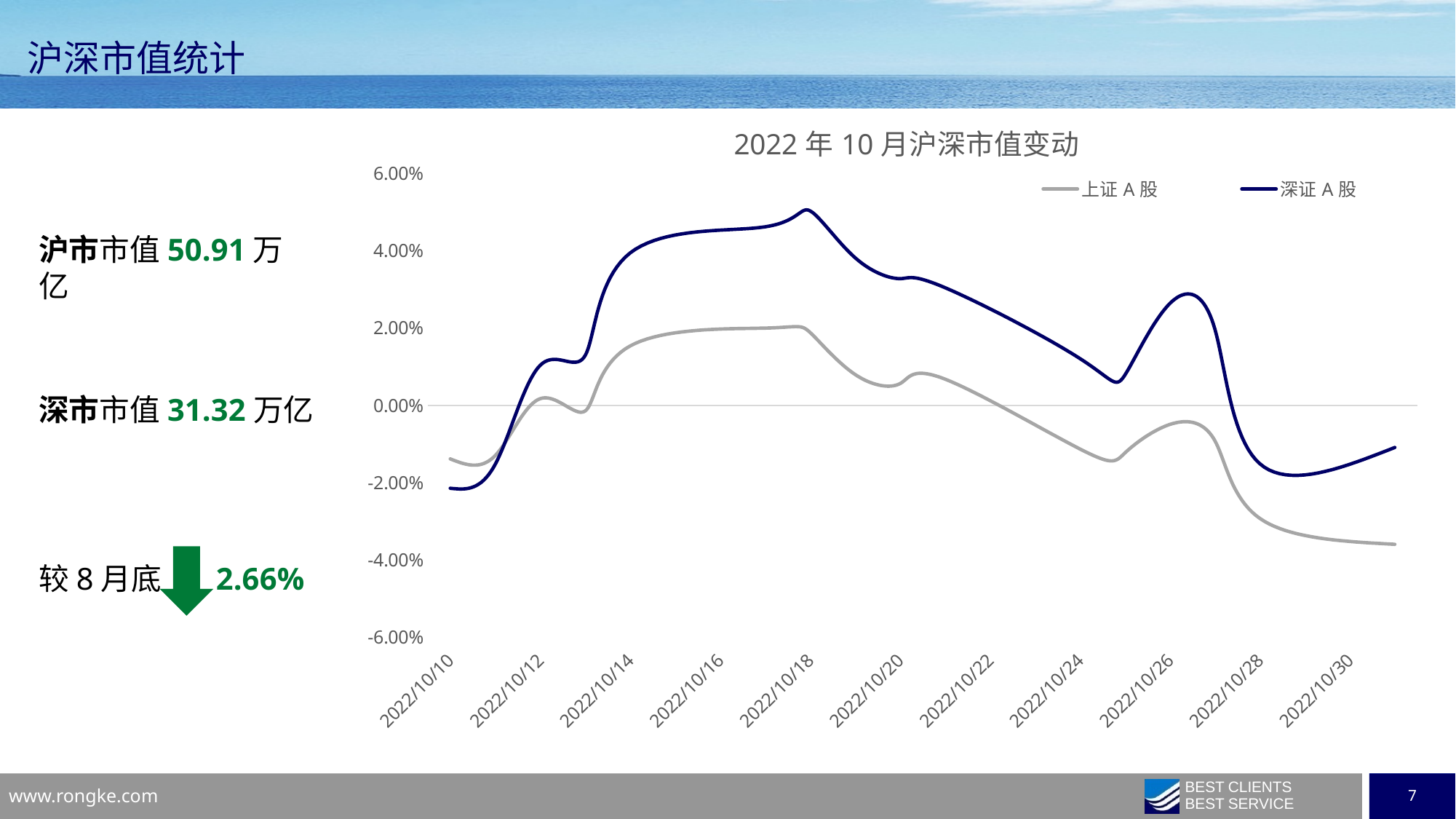
Which series is drawn in dark blue in the chart? 深证 A 股 How many series does the chart legend list? 2 At 2022/10/18, which series has the higher value, 上证 A 股 or 深证 A 股? 深证 A 股 Between 2022/10/18 and 2022/10/24, does the 深证 A 股 line rise or fall? fall At 2022/10/30, which series has the lower value, 上证 A 股 or 深证 A 股? 上证 A 股 What is the title of the chart? 2022 年 10 月沪深市值变动 Is the value for 深证 A 股 at 2022/10/10 greater or less than 0.00%? less Is the value for 上证 A 股 at 2022/10/30 greater or less than -2.00%? less What kind of chart is shown on the slide? line chart Is the value for 深证 A 股 at 2022/10/26 greater or less than 2.00%? greater How many date labels are shown on the x axis of the chart? 11